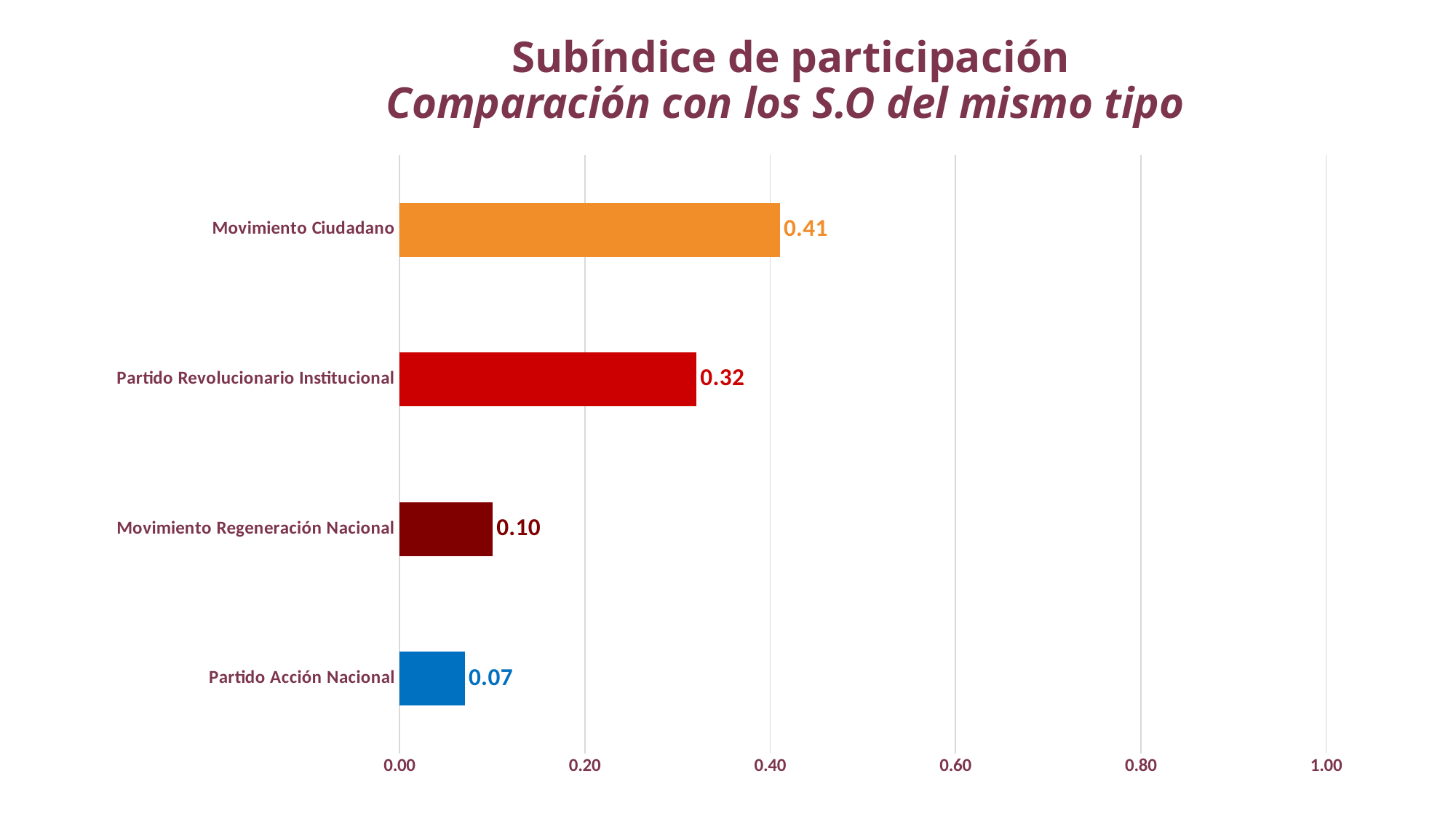
What is the difference between the values for Movimiento Ciudadano and Partido Revolucionario Institucional? 0.09 What is the value for Movimiento Regeneración Nacional? 0.10 Which category has the lowest value? Partido Acción Nacional What is the value for Partido Acción Nacional? 0.07 Which category has the highest value? Movimiento Ciudadano Is the value for Partido Revolucionario Institucional greater or less than 0.40? less What is the value for Movimiento Ciudadano? 0.41 What is the title of the chart? Subíndice de participación Comparación con los S.O del mismo tipo How many categories are shown in the chart? 4 What is the value for Partido Revolucionario Institucional? 0.32 Which is larger, the value for Movimiento Regeneración Nacional or the value for Partido Acción Nacional? Movimiento Regeneración Nacional What kind of chart is shown on the slide? bar chart